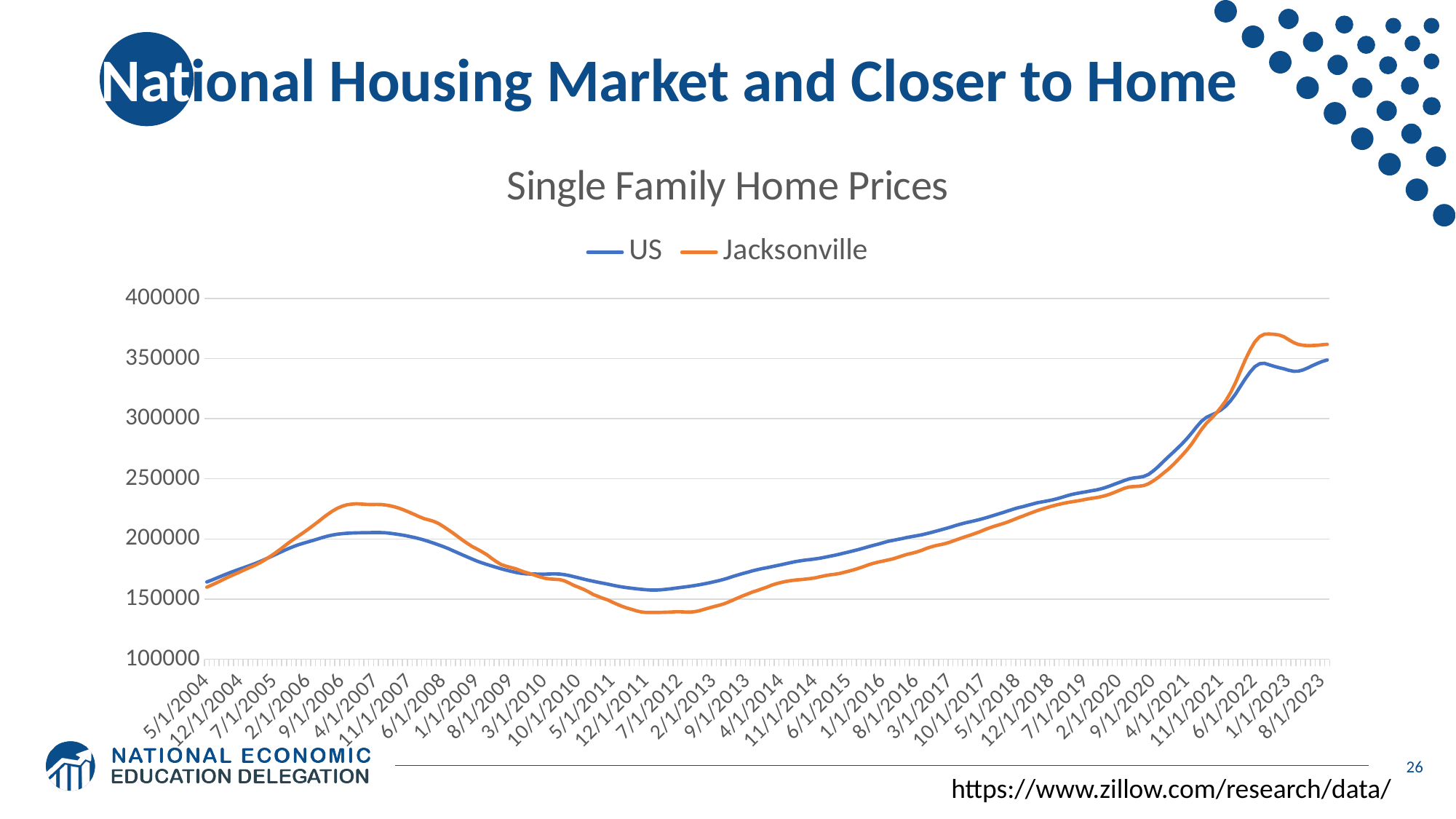
How many series does the legend list? 2 Which series reaches the highest value anywhere on the chart? Jacksonville Is the value for Jacksonville at 7/1/2012 greater or less than 150000? less Is the value for Jacksonville at 4/1/2007 greater or less than 200000? greater What is the title of the chart? Single Family Home Prices Which colour is the Jacksonville line? orange At 4/1/2007, which series has the higher value, US or Jacksonville? Jacksonville At 7/1/2012, which series has the higher value, US or Jacksonville? US Is the value for Jacksonville at 8/1/2023 greater or less than 350000? greater What kind of chart is shown on the slide? line chart Does the US line rise or fall between 7/1/2012 and 4/1/2021? rise